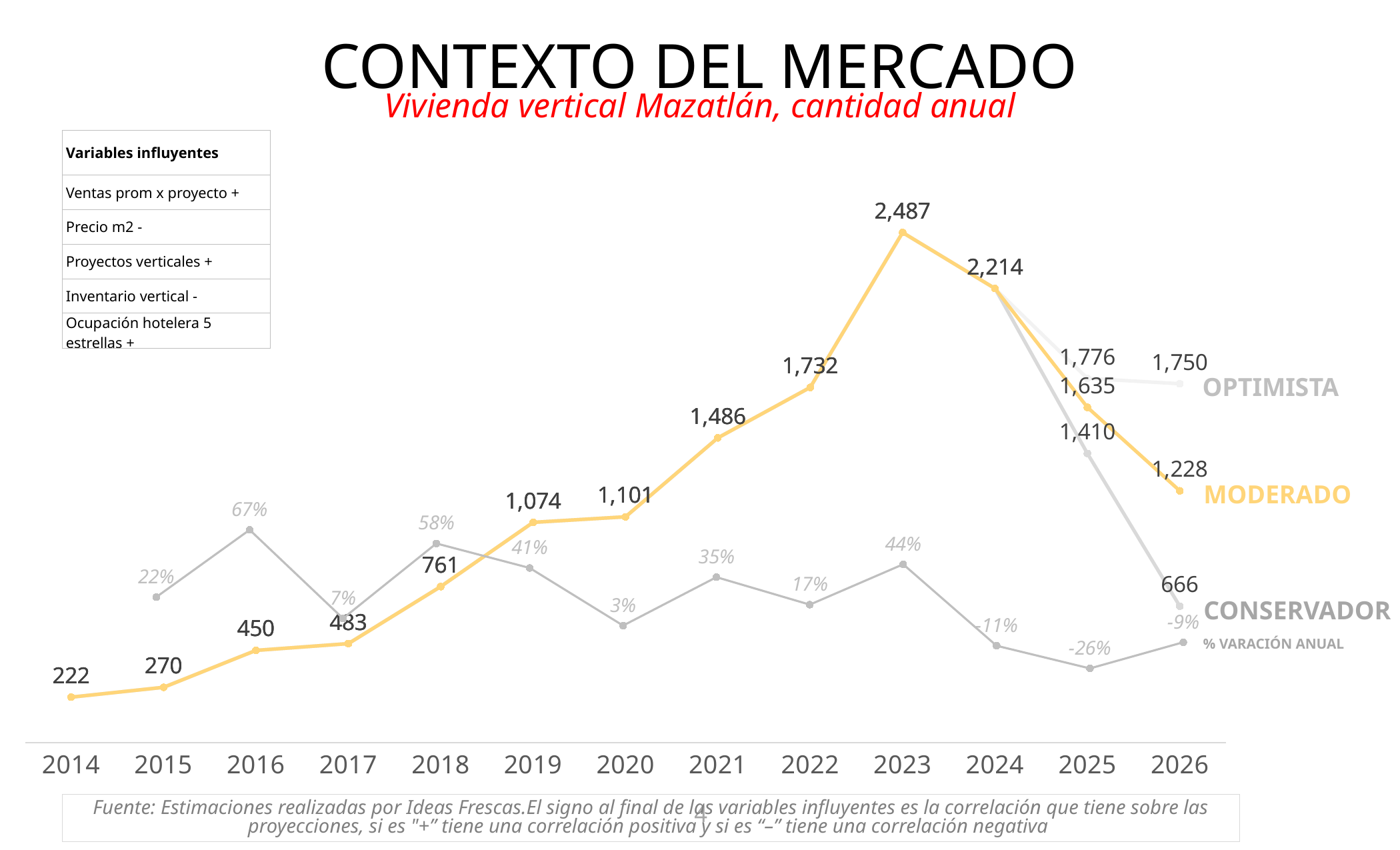
Which year has the highest value on the main line? 2023 How many years are shown on the x axis? 13 What is the difference between the 2023 value (2,487) and the 2024 value (2,214)? 273 Which is larger for 2026, the OPTIMISTA value or the CONSERVADOR value? OPTIMISTA What is the CONSERVADOR scenario value for 2026? 666 What is the value shown for 2014? 222 What is the % variación anual shown for 2016? 67% What is the value shown for 2023 on the main line? 2,487 What is the OPTIMISTA scenario value for 2025? 1,776 What kind of chart is shown on the slide? Line chart What is the lowest % variación anual value shown? -26% What is the MODERADO scenario value for 2026? 1,228